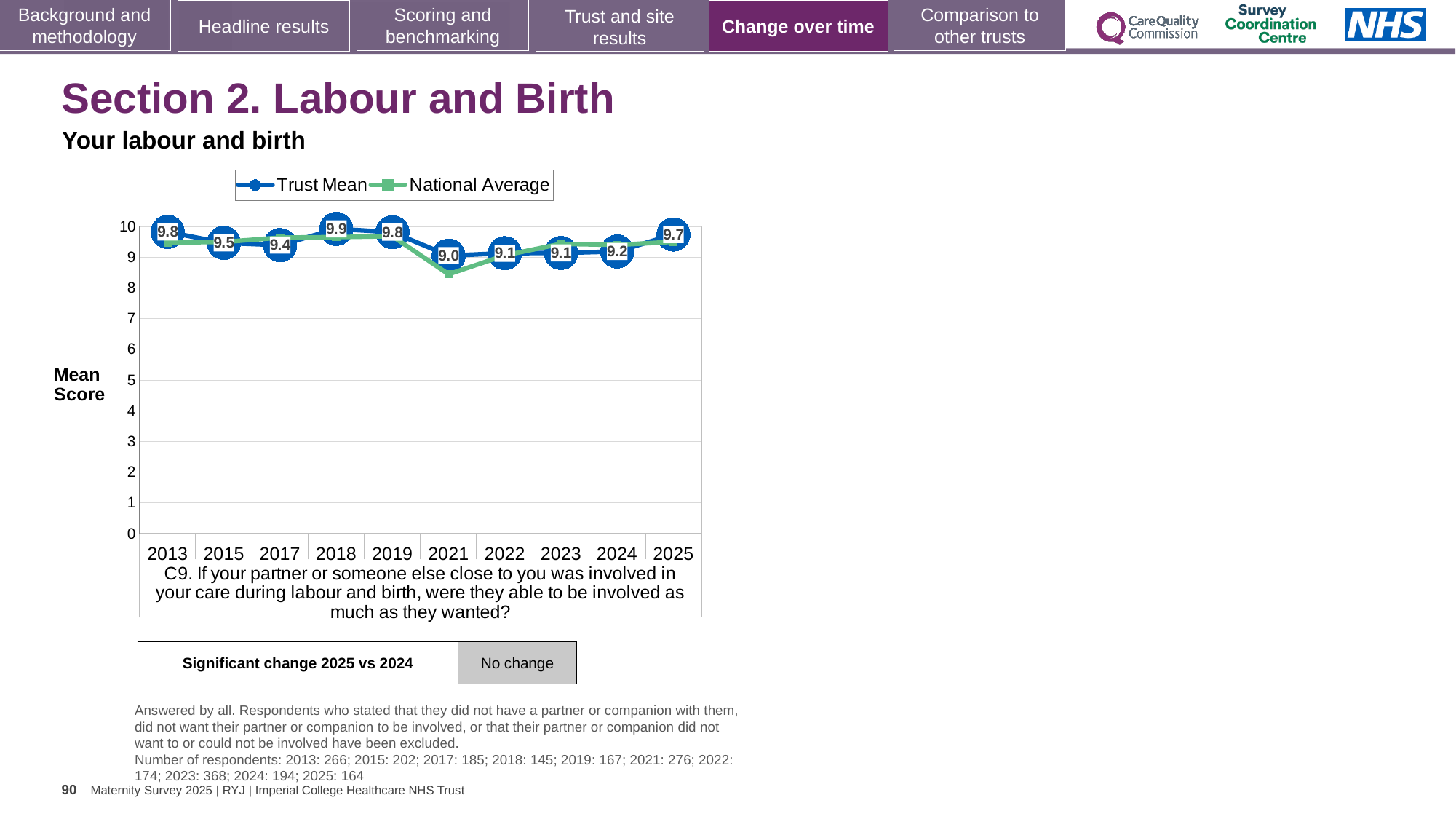
What kind of chart is shown on the slide? line chart Is the National Average value for 2021 greater or less than 9? less What is the Trust Mean value for 2025? 9.7 In which year is the Trust Mean highest? 2018 Does the Trust Mean rise or fall from 2019 to 2021? fall What is the difference between the Trust Mean in 2018 and in 2021? 0.9 How many series does the legend list? 2 Which year has the larger Trust Mean, 2017 or 2025? 2025 How many years are shown on the x axis? 10 In which year is the Trust Mean lowest? 2021 What is the Trust Mean value for 2021? 9.0 What is the Trust Mean value for 2013? 9.8